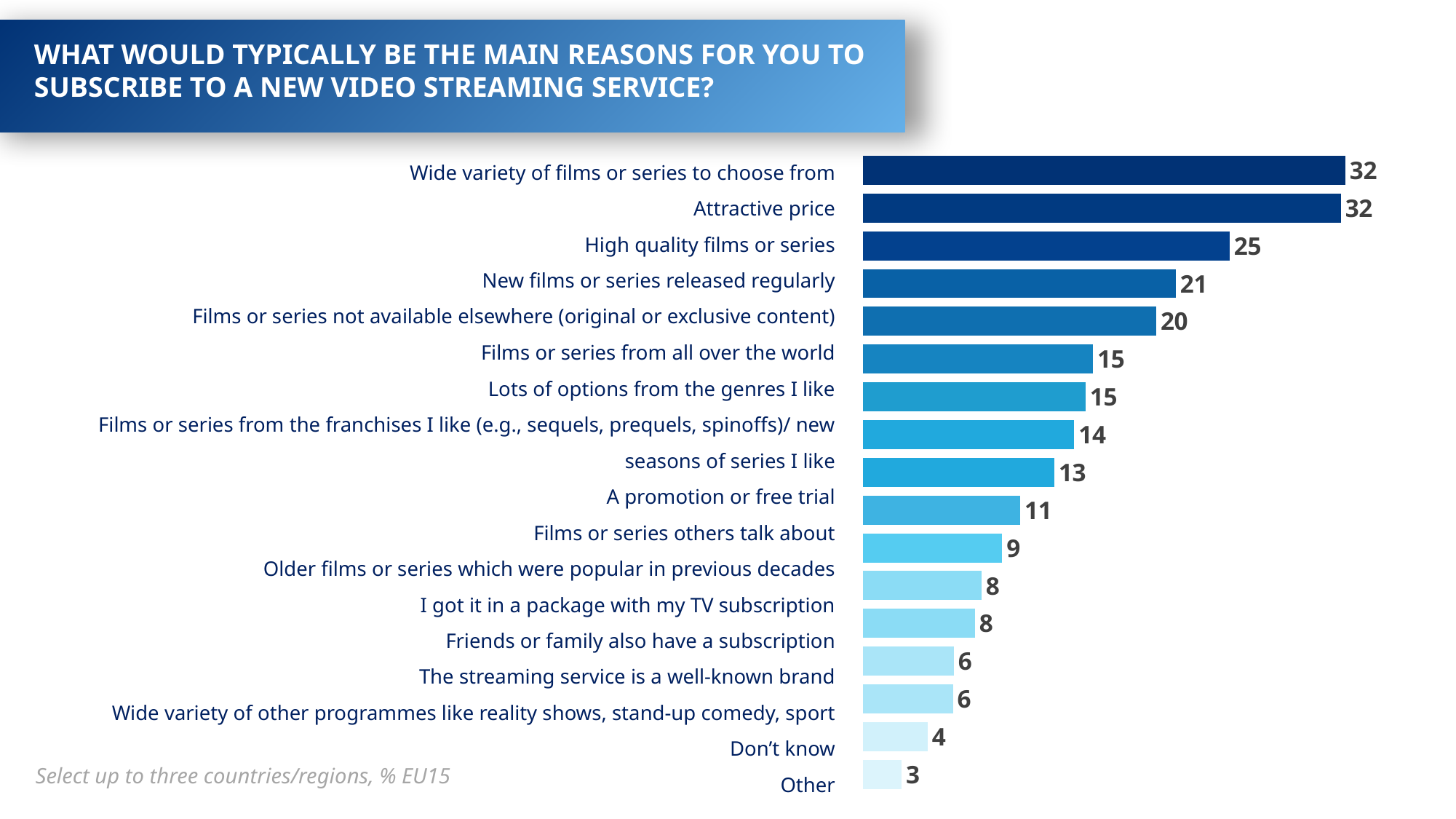
What is the value for Attractive price? 32 What kind of chart is shown on the slide? Bar chart What is the value for High quality films or series? 25 How many bars are plotted in the chart? 17 What is the value for New films or series released regularly? 21 What is the value for Films or series not available elsewhere (original or exclusive content)? 20 What is the note printed at the bottom left of the slide? Select up to three countries/regions, % EU15 Which is larger: the value for Films or series not available elsewhere (original or exclusive content) or the value for Lots of options from the genres I like? Films or series not available elsewhere (original or exclusive content) What is the difference between the values for Wide variety of films or series to choose from and Films or series from all over the world? 17 What is the value for Other? 3 Which category has the lowest value? Other What is the difference between the values for High quality films or series and New films or series released regularly? 4